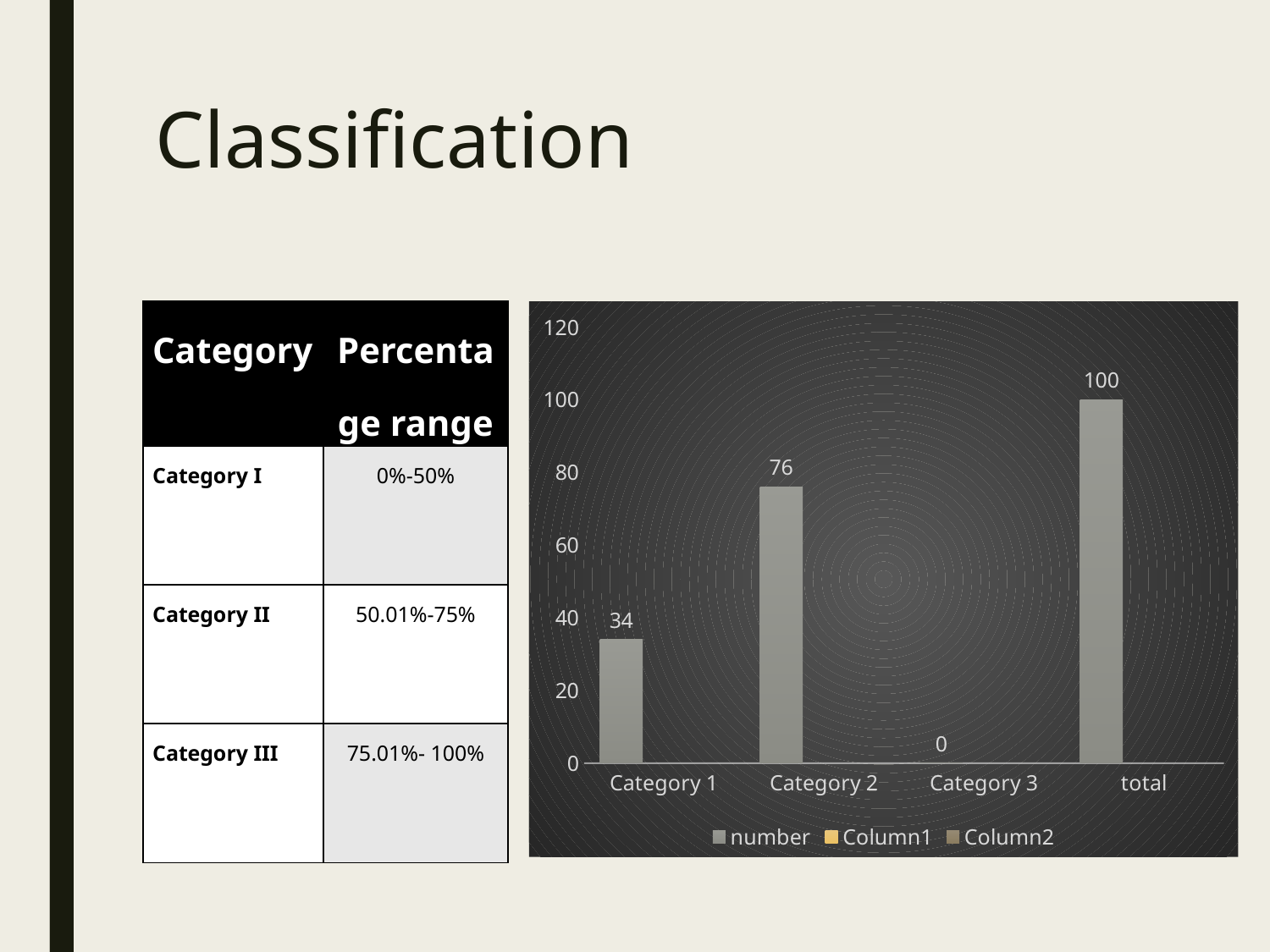
How many categories are shown on the x axis of the chart? 4 What is the value for Category 2 in the chart? 76 Which is larger, the value for Category 1 or the value for Category 2? Category 2 What kind of chart is shown on the slide? bar chart Which category has the lowest value in the chart? Category 3 How many series does the chart legend list? 3 What is the value for Category 3 in the chart? 0 Which category has the highest value in the chart? total What is the first series name listed in the chart legend? number What is the difference between the values for Category 2 and Category 1? 42 What is the value for total in the chart? 100 What is the value for Category 1 in the chart? 34